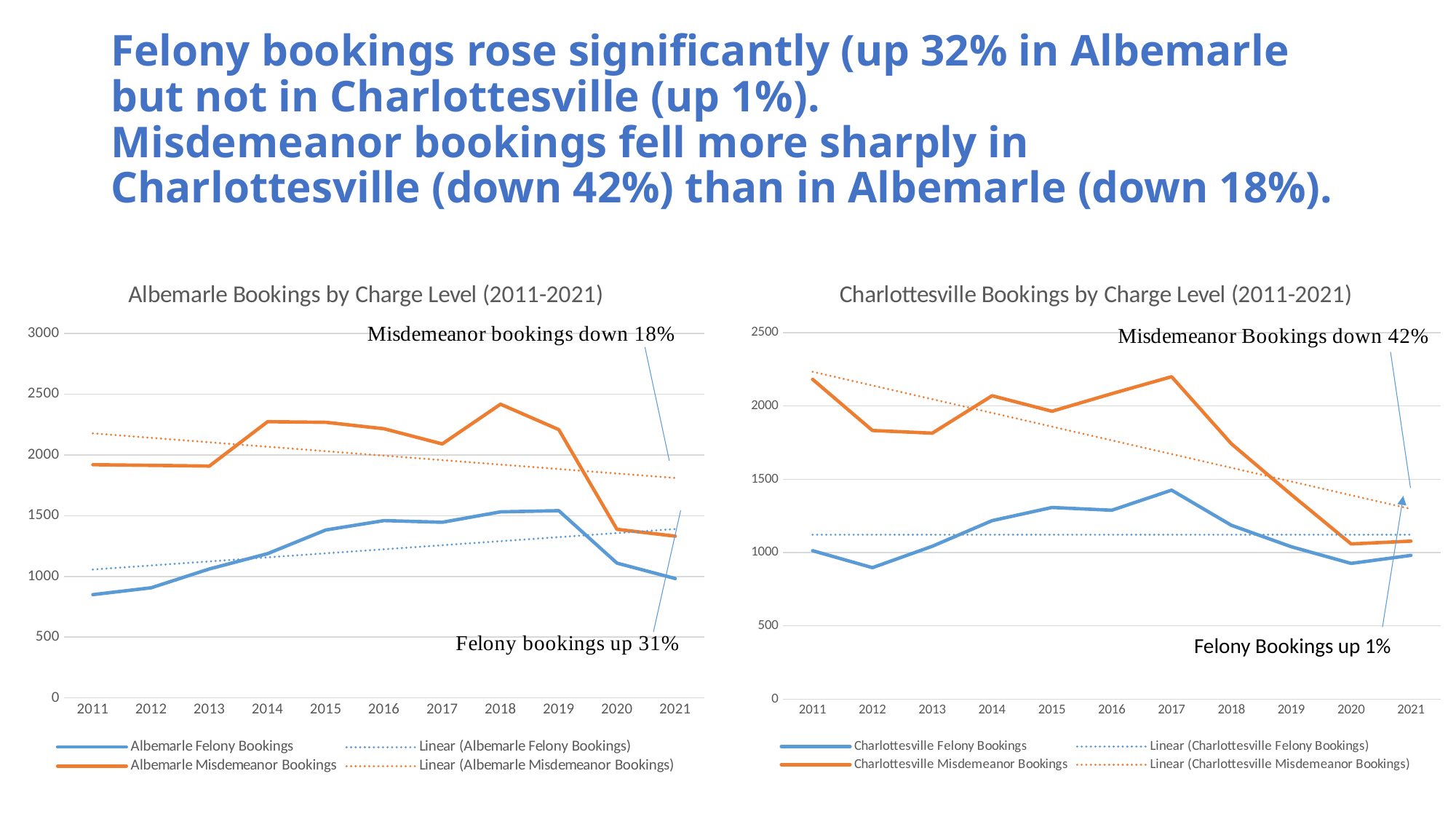
In the Charlottesville Bookings by Charge Level (2011-2021) chart, which year has the lowest value for Charlottesville Felony Bookings? 2012 In the Charlottesville Bookings by Charge Level (2011-2021) chart, which year has the highest value for Charlottesville Felony Bookings? 2017 What kind of chart is the Albemarle Bookings by Charge Level (2011-2021) chart? line chart How many years are shown on the x axis of the Charlottesville Bookings by Charge Level (2011-2021) chart? 11 In the Charlottesville Bookings by Charge Level (2011-2021) chart, do Charlottesville Misdemeanor Bookings rise or fall overall from 2011 to 2021? fall According to the annotation on the Albemarle Bookings by Charge Level (2011-2021) chart, by what percentage did felony bookings go up? 31% How many entries does the legend of the Albemarle Bookings by Charge Level (2011-2021) chart list? 4 In the Charlottesville Bookings by Charge Level (2011-2021) chart, which is larger in 2020: Charlottesville Felony Bookings or Charlottesville Misdemeanor Bookings? Charlottesville Misdemeanor Bookings In the Albemarle Bookings by Charge Level (2011-2021) chart, is the value for Albemarle Misdemeanor Bookings in 2011 greater or less than 1500? greater In the Albemarle Bookings by Charge Level (2011-2021) chart, which year has the highest value for Albemarle Misdemeanor Bookings? 2018 In the Albemarle Bookings by Charge Level (2011-2021) chart, which year has the lowest value for Albemarle Felony Bookings? 2011 In the Charlottesville Bookings by Charge Level (2011-2021) chart, is the value for Charlottesville Misdemeanor Bookings in 2021 greater or less than 1500? less